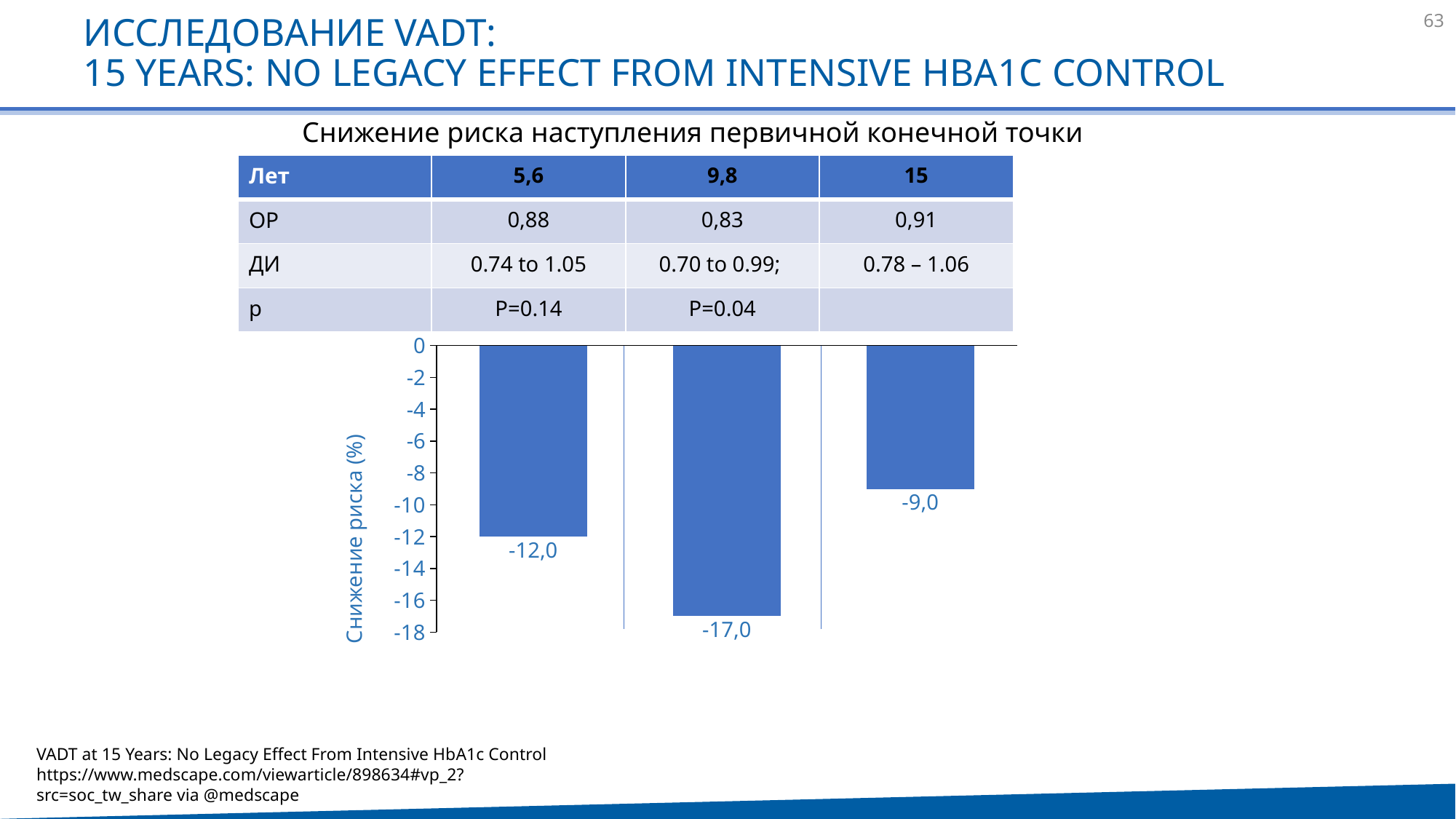
Which bar extends furthest below zero on the chart? The middle bar (-17,0) How many bars are plotted on the chart? 3 What is the difference between the values of the first bar (-12,0) and the middle bar (-17,0)? 5,0 What is the value shown on the middle bar of the chart? -17,0 What is the value shown on the third (rightmost) bar of the chart? -9,0 Which bar is the shortest (closest to zero) on the chart? The rightmost bar (-9,0) Which bar reaches further below zero: the leftmost bar or the rightmost bar? The leftmost bar What is the difference between the values of the middle bar (-17,0) and the rightmost bar (-9,0)? 8,0 What is the value shown on the first (leftmost) bar of the chart? -12,0 What type of chart is shown on the slide? Bar chart What is the lowest tick value shown on the vertical axis of the chart? -18 What is the label of the vertical axis of the chart? Снижение риска (%)